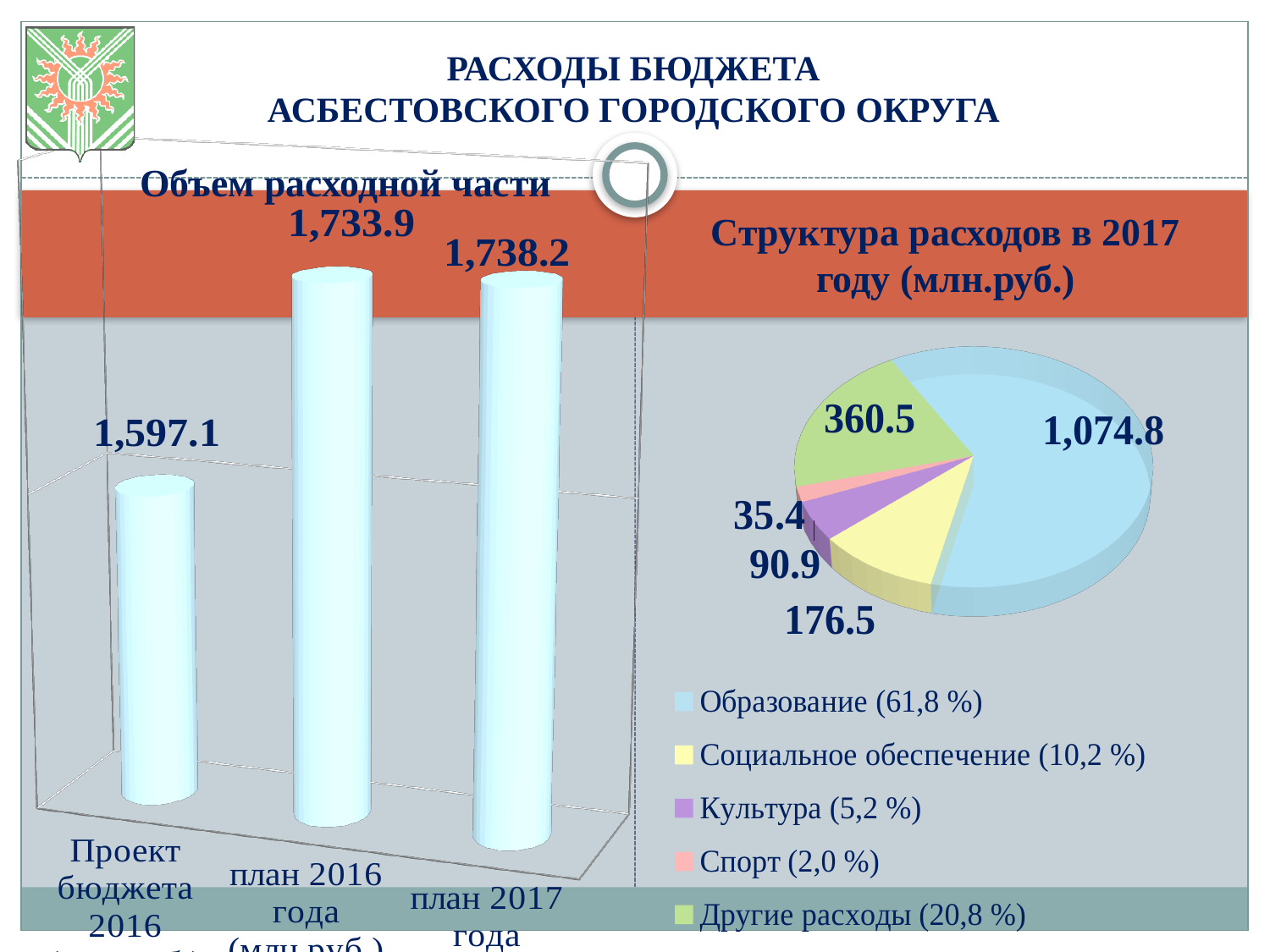
In the pie chart 'Структура расходов в 2017 году (млн.руб.)', which category has the smallest slice? Спорт In the bar chart 'Объем расходной части', what is the value for 'Проект бюджета 2016'? 1,597.1 In the pie chart 'Структура расходов в 2017 году (млн.руб.)', what share does 'Другие расходы' have? 20,8 % In the bar chart 'Объем расходной части', what is the difference between 'план 2017 года' and 'Проект бюджета 2016'? 141.1 In the bar chart 'Объем расходной части', how many bars are shown? 3 In the bar chart 'Объем расходной части', which category has the lowest value? Проект бюджета 2016 In the bar chart 'Объем расходной части', which category has the highest value? план 2017 года In the pie chart 'Структура расходов в 2017 году (млн.руб.)', what is the value for 'Спорт'? 35.4 What type of chart is 'Объем расходной части'? Bar chart In the pie chart 'Структура расходов в 2017 году (млн.руб.)', how many categories does the legend list? 5 In the bar chart 'Объем расходной части', what is the value for 'план 2017 года'? 1,738.2 In the pie chart 'Структура расходов в 2017 году (млн.руб.)', what is the value for 'Образование'? 1,074.8